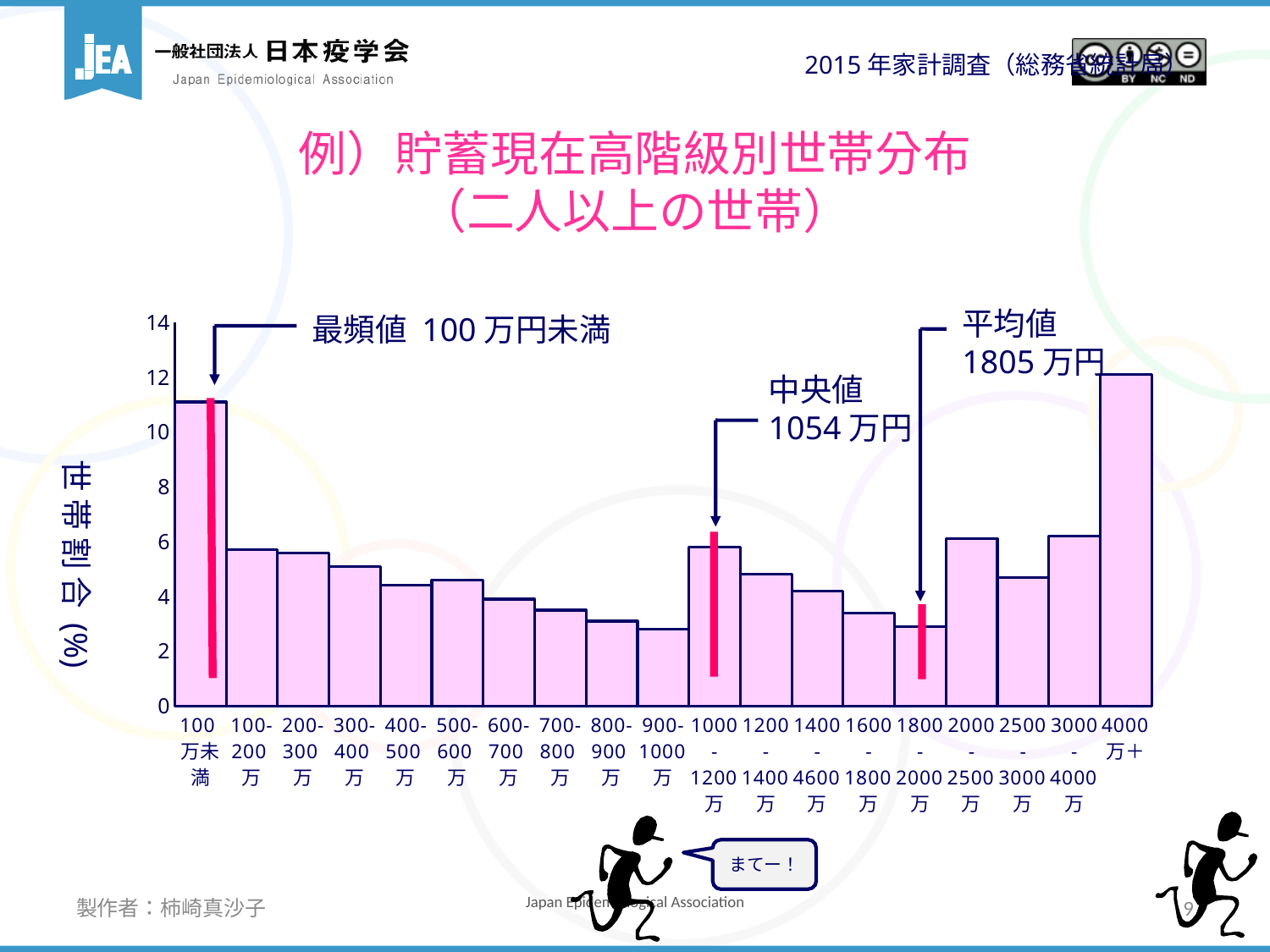
According to the annotation on the chart, what is the median (中央値) savings value? 1054万円 Which savings category has the highest household share in the chart? 4000万+ What kind of chart is shown on the slide? bar chart Is the value for 1800-2000万 greater or less than 4? less Which is larger, the value for 100-200万 or the value for 500-600万? 100-200万 How many savings categories are shown along the x axis of the chart? 19 Is the value for 100万未満 greater or less than 10? greater Is the value for 1000-1200万 greater or less than 4? greater Do the values rise or fall along the x axis from 100-200万 to 900-1000万? fall Which is larger, the value for 1200-1400万 or the value for 1600-1800万? 1200-1400万 What is the label of the y axis of the chart? 世帯割合(%)